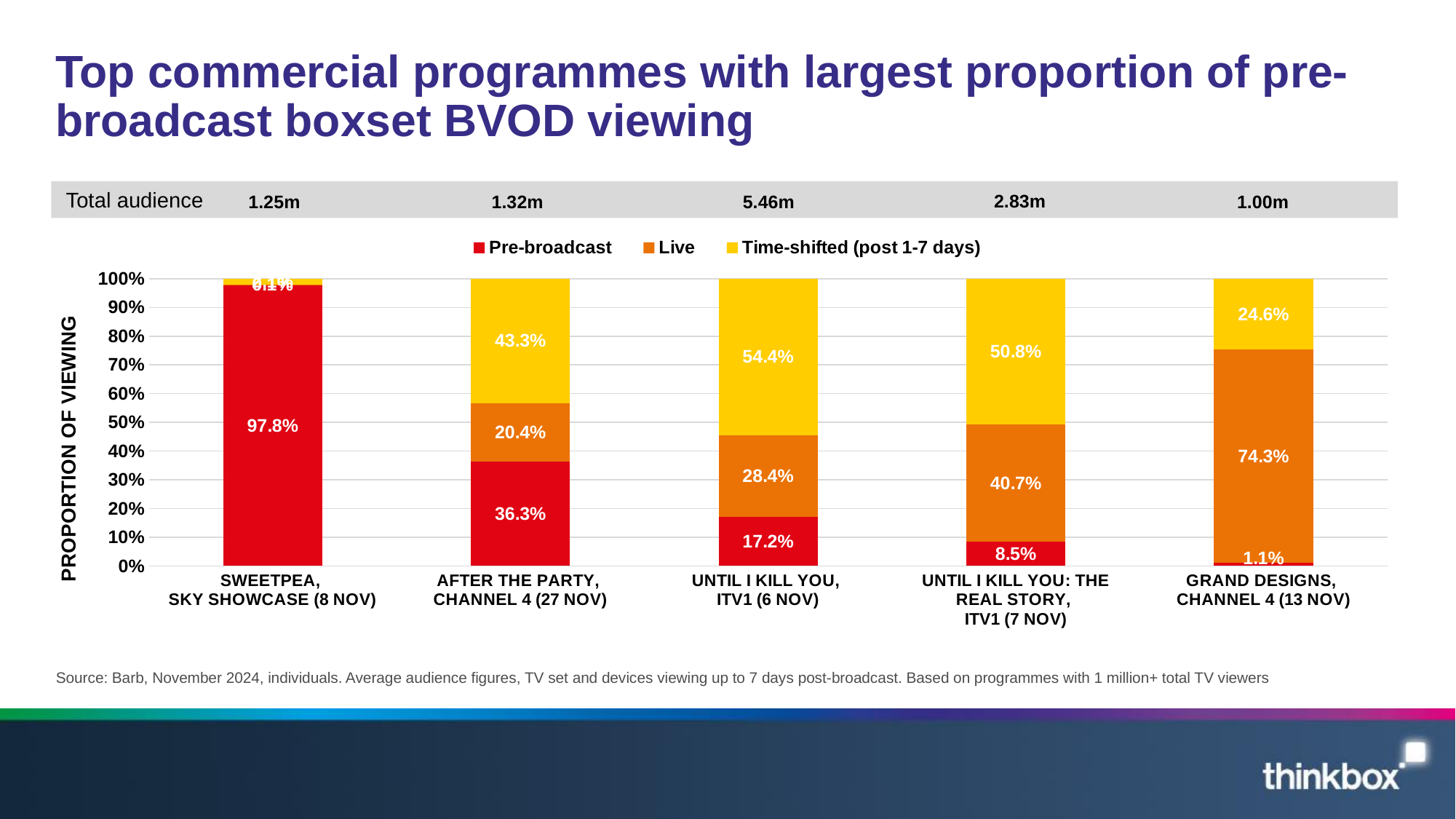
How many series does the legend list? 3 What is the total audience shown for Until I Kill You, ITV1 (6 Nov)? 5.46m What is the Pre-broadcast share of viewing for After the Party, Channel 4 (27 Nov)? 36.3% Which programme has the highest Time-shifted (post 1-7 days) share of viewing? Until I Kill You, ITV1 (6 Nov) Is the Live share of viewing larger for Until I Kill You, ITV1 (6 Nov) or for Until I Kill You: The Real Story, ITV1 (7 Nov)? Until I Kill You: The Real Story, ITV1 (7 Nov) What is the difference between the Time-shifted and Pre-broadcast shares for After the Party, Channel 4 (27 Nov)? 7.0 percentage points Which programme has the lowest Pre-broadcast share of viewing? Grand Designs, Channel 4 (13 Nov) Which programme has the highest Pre-broadcast share of viewing? Sweetpea, Sky Showcase (8 Nov) What is the Live share of viewing for Grand Designs, Channel 4 (13 Nov)? 74.3% How many programmes are shown on the chart? 5 What is the Live share of viewing for Until I Kill You: The Real Story, ITV1 (7 Nov)? 40.7% What is the Time-shifted (post 1-7 days) share of viewing for Until I Kill You, ITV1 (6 Nov)? 54.4%